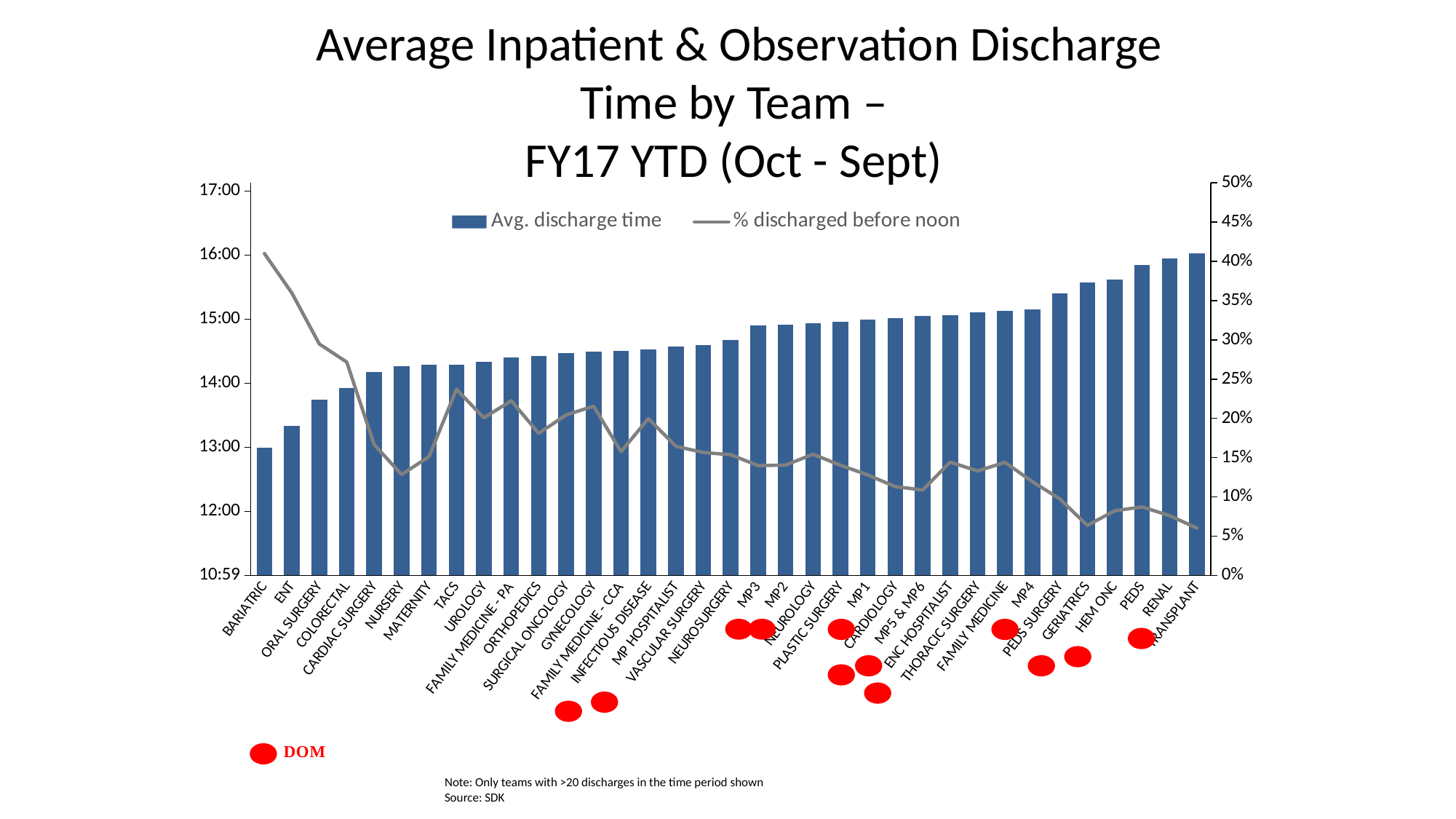
Do the average discharge time bars rise or fall from left to right along the x axis? Rise How many teams are shown on the x axis? 35 What is the title of the chart? Average Inpatient & Observation Discharge Time by Team – FY17 YTD (Oct - Sept) Which team has the latest average discharge time? TRANSPLANT What kind of chart is shown on the slide? Bar chart with a line overlay Which team has a later average discharge time, ENT or RENAL? RENAL Which team has the earliest average discharge time? BARIATRIC Which team has the highest % discharged before noon? BARIATRIC How many series does the legend list? 2